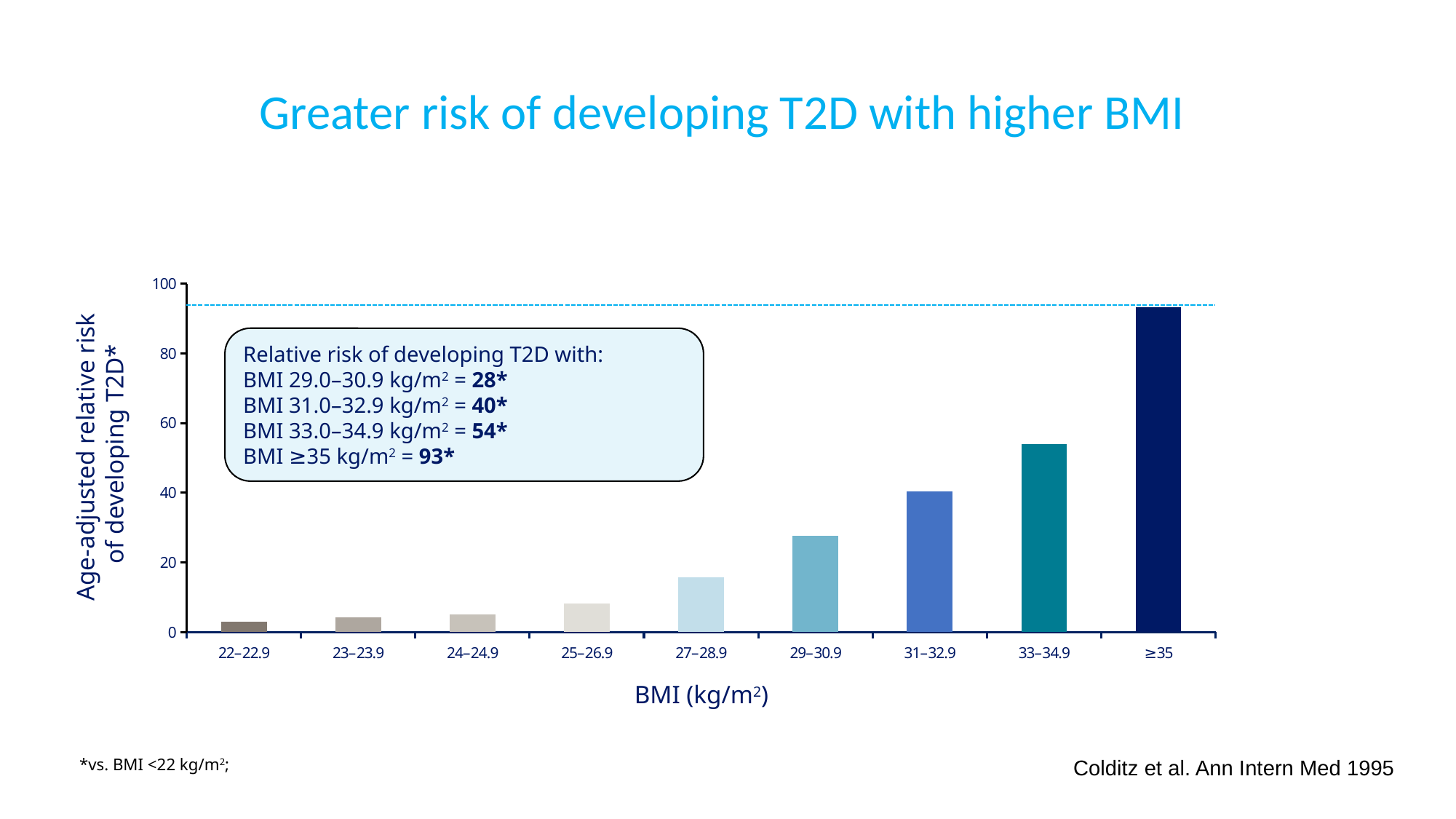
What kind of chart is shown on the slide? Bar chart Which BMI category has the highest relative risk of developing T2D? ≥35 What is the difference in relative risk between the 31–32.9 and 29–30.9 BMI categories? 12 What is the age-adjusted relative risk of developing T2D for a BMI of ≥35 kg/m²? 93 What is the age-adjusted relative risk of developing T2D for a BMI of 31–32.9 kg/m²? 40 What is the age-adjusted relative risk of developing T2D for a BMI of 33–34.9 kg/m²? 54 What is the age-adjusted relative risk of developing T2D for a BMI of 29–30.9 kg/m²? 28 Does the relative risk of developing T2D rise or fall as BMI increases along the x axis? Rises How many BMI categories are shown on the chart? 9 Is the relative risk for the 27–28.9 BMI category greater or less than 20? less What is the difference in relative risk between the ≥35 and 33–34.9 BMI categories? 39 Which BMI category has the lowest relative risk of developing T2D? 22–22.9